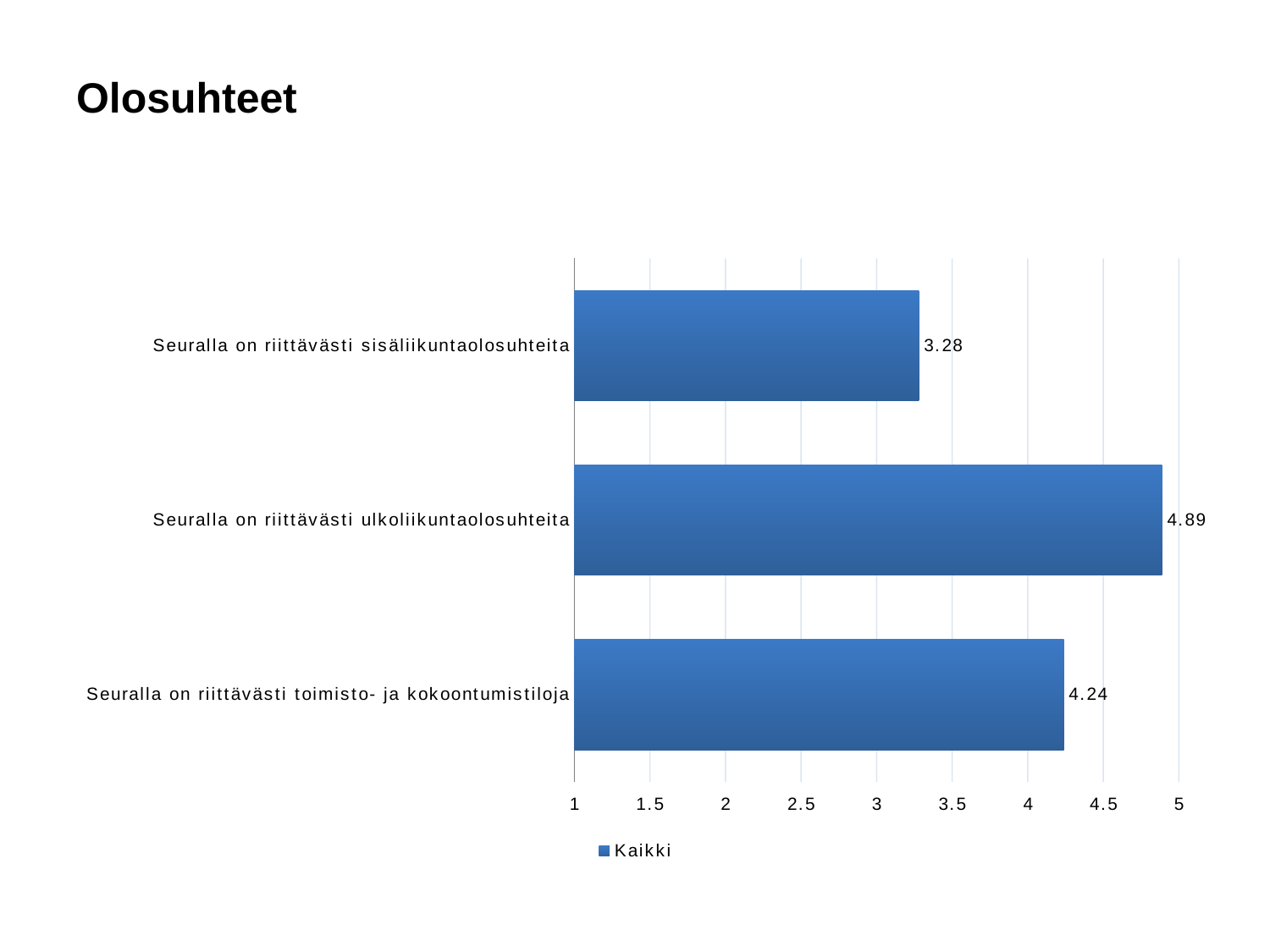
What is the difference between the values for "Seuralla on riittävästi ulkoliikuntaolosuhteita" and "Seuralla on riittävästi toimisto- ja kokoontumistiloja"? 0.65 What is the difference between the values for "Seuralla on riittävästi ulkoliikuntaolosuhteita" and "Seuralla on riittävästi sisäliikuntaolosuhteita"? 1.61 What is the value for "Seuralla on riittävästi toimisto- ja kokoontumistiloja"? 4.24 What kind of chart is shown on the slide? bar chart Which category has the highest value? Seuralla on riittävästi ulkoliikuntaolosuhteita What is the value for "Seuralla on riittävästi ulkoliikuntaolosuhteita"? 4.89 Which category has the lowest value? Seuralla on riittävästi sisäliikuntaolosuhteita How many categories are shown in the chart? 3 How many series does the legend list? 1 Is the value for "Seuralla on riittävästi sisäliikuntaolosuhteita" greater or less than 3.5? less Which is larger: the value for "Seuralla on riittävästi toimisto- ja kokoontumistiloja" or for "Seuralla on riittävästi sisäliikuntaolosuhteita"? Seuralla on riittävästi toimisto- ja kokoontumistiloja What is the value for "Seuralla on riittävästi sisäliikuntaolosuhteita"? 3.28